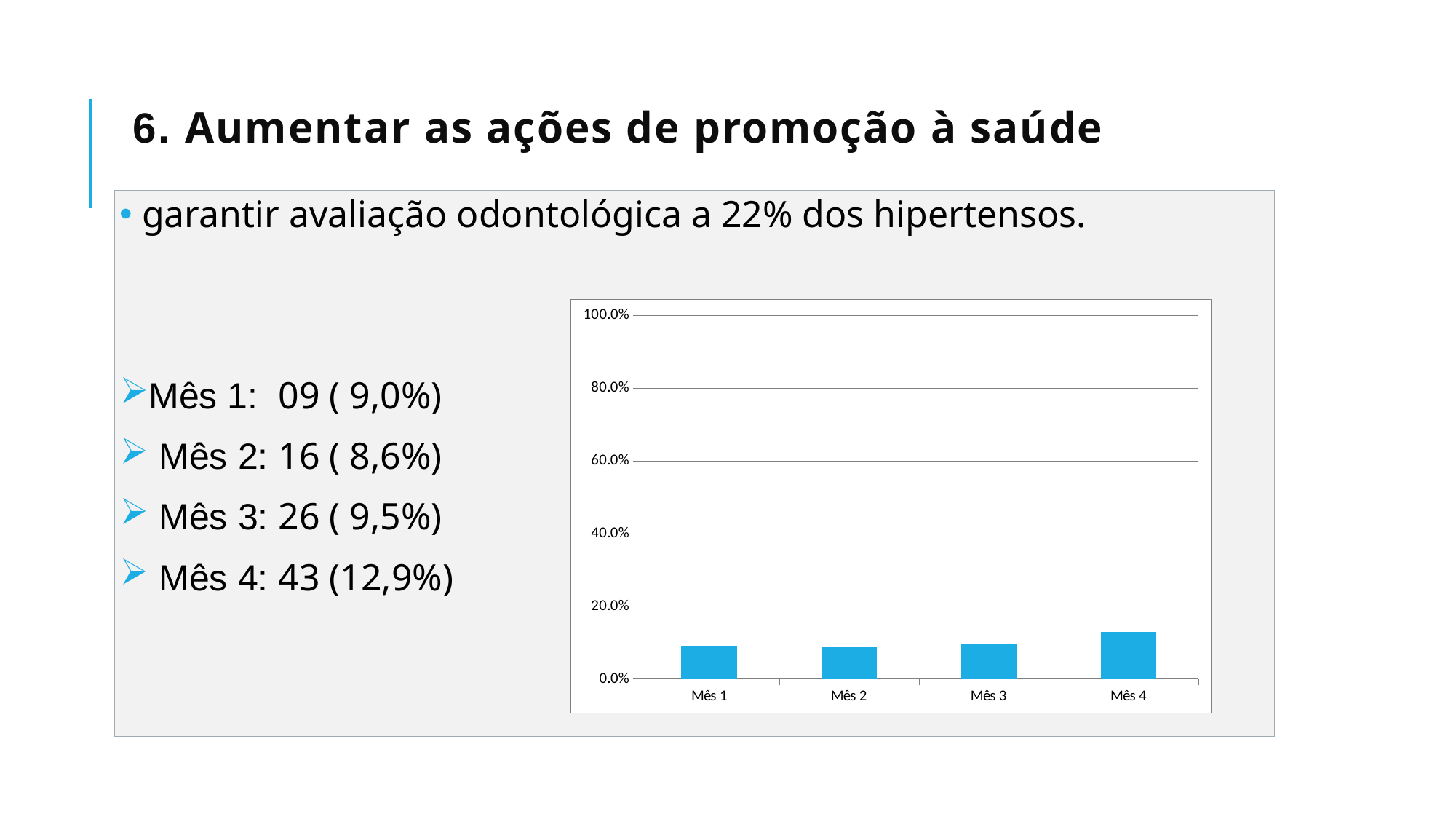
How many categories (months) are plotted on the x axis of the chart? 4 Is the bar for Mês 1 greater or less than 20.0%? less Which is larger, the bar for Mês 4 or the bar for Mês 1? Mês 4 What colour are the bars in the chart? blue Does the value rise or fall from Mês 3 to Mês 4? rise Is the bar for Mês 3 greater or less than 40.0%? less What kind of chart is shown on the slide? bar chart Which is larger, the bar for Mês 2 or the bar for Mês 4? Mês 4 Which month has the highest bar in the chart? Mês 4 What is the highest value shown on the chart's y axis? 100.0% Is the bar for Mês 4 greater or less than 20.0%? less